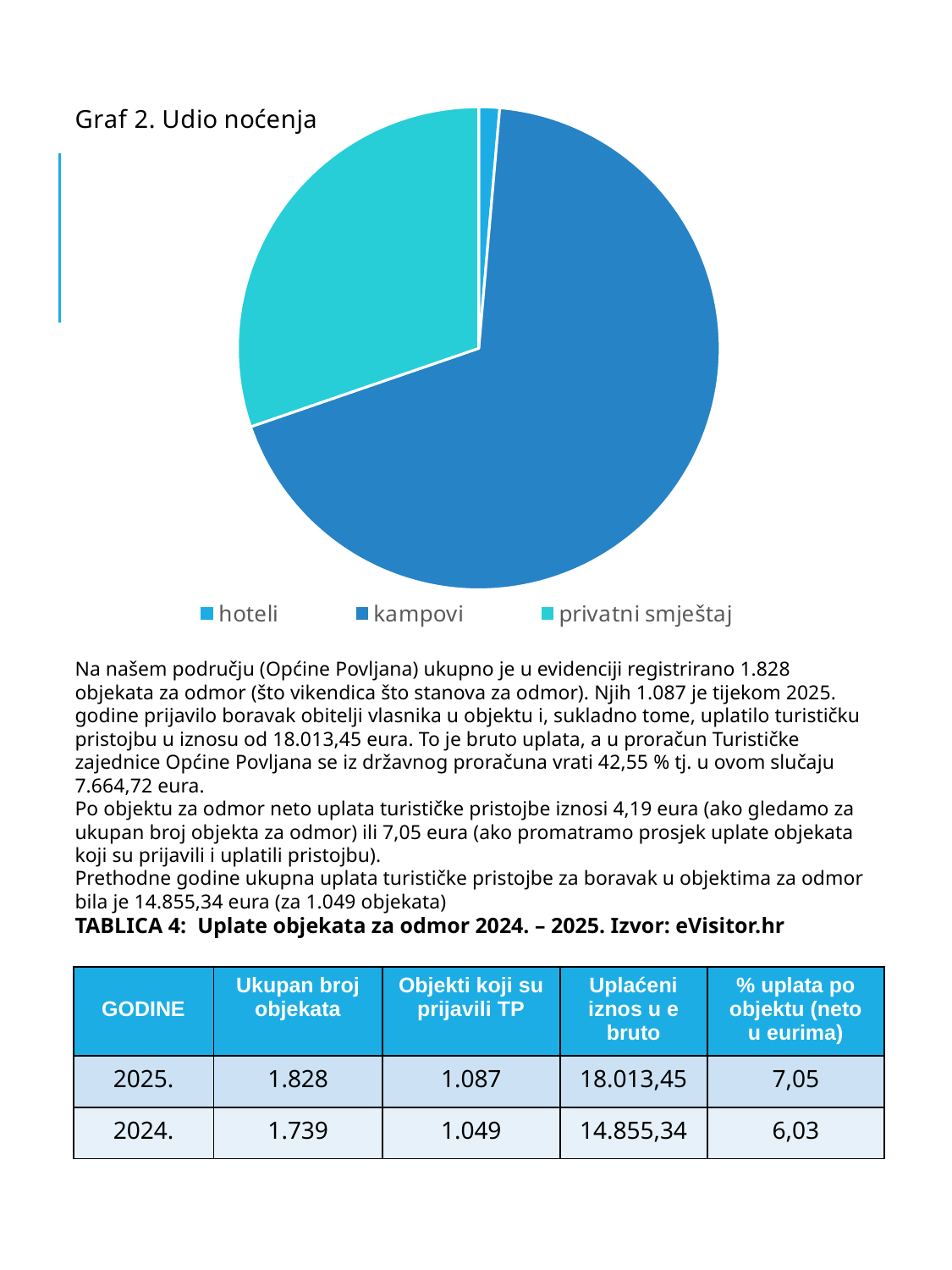
How many slices does the pie chart "Graf 2. Udio noćenja" have? 3 Which category has the largest slice in the pie chart "Graf 2. Udio noćenja"? kampovi In the pie chart "Graf 2. Udio noćenja", which slice is larger: kampovi or privatni smještaj? kampovi In the pie chart "Graf 2. Udio noćenja", which slice is larger: hoteli or privatni smještaj? privatni smještaj What is the title of the pie chart on the slide? Graf 2. Udio noćenja Which legend entries are listed for the pie chart "Graf 2. Udio noćenja"? hoteli, kampovi, privatni smještaj How many entries does the legend of the pie chart "Graf 2. Udio noćenja" list? 3 Which category has the smallest slice in the pie chart "Graf 2. Udio noćenja"? hoteli What kind of chart is shown under the title "Graf 2. Udio noćenja"? pie chart